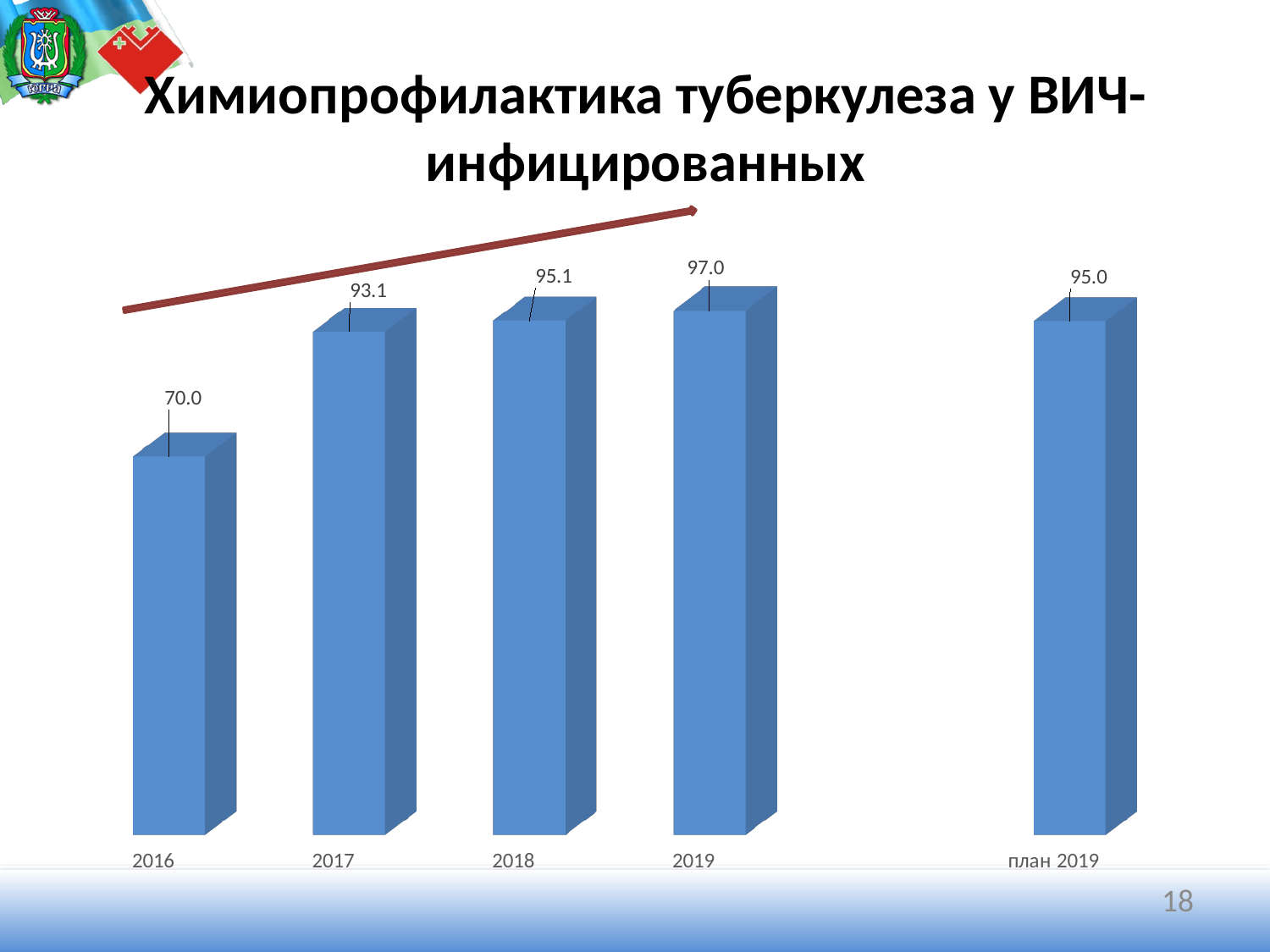
What is the value for 2016? 70.0 Which category has the highest value? 2019 What is the difference between the values for 2019 and план 2019? 2.0 Which is larger, the value for 2017 or the value for 2018? 2018 What is the difference between the values for 2019 and 2016? 27.0 How many bars are shown in the chart? 5 What is the value for 2019? 97.0 What is the value for 2018? 95.1 What is the value for план 2019? 95.0 What kind of chart is shown on the slide? bar chart Which category has the lowest value? 2016 What is the value for 2017? 93.1